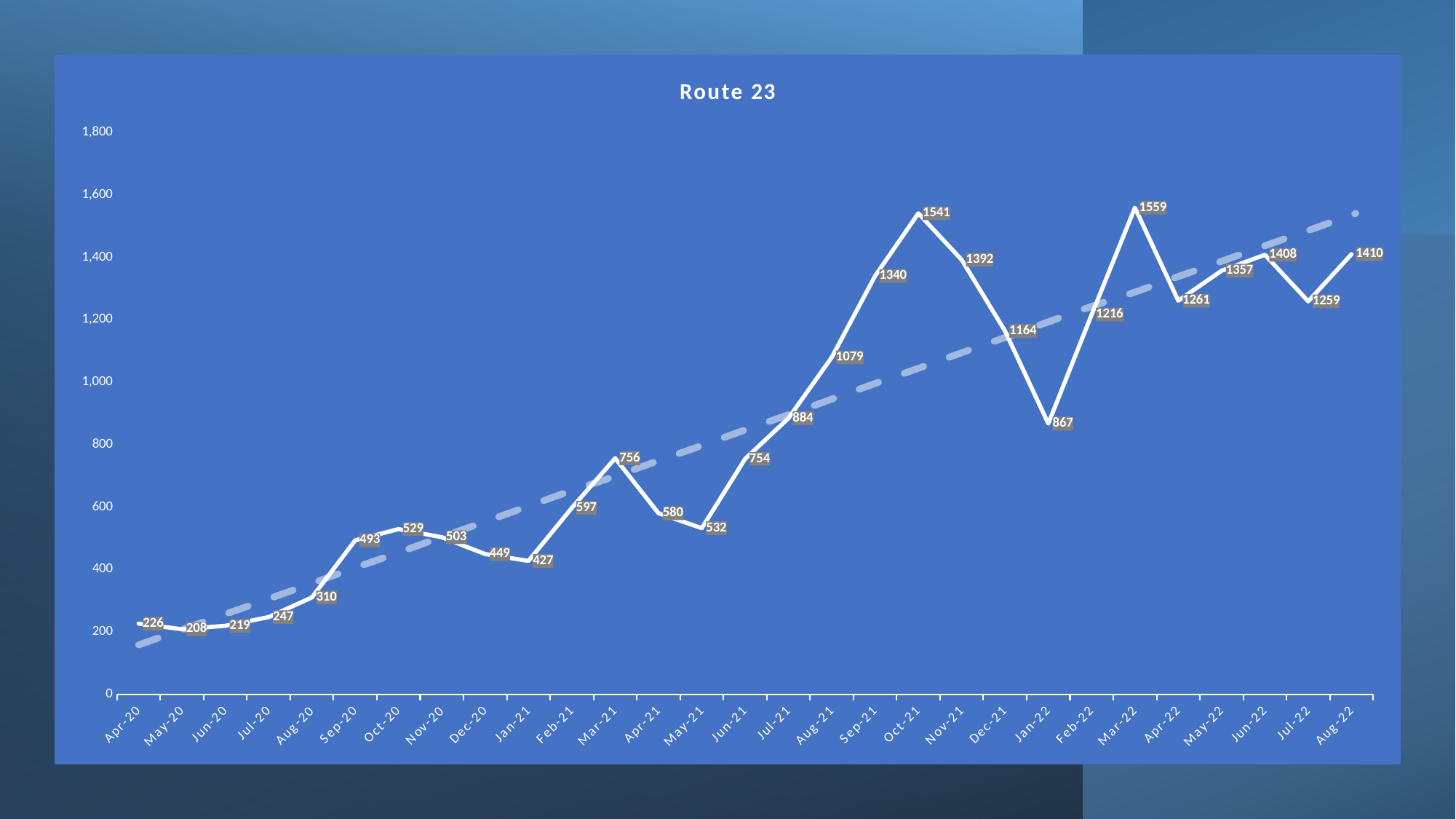
What type of chart is shown on the slide? line chart Is the value for Dec-21 greater or less than 1,000? greater What is the value for Jan-22? 867 Which is larger, the value for Jun-22 or the value for Aug-22? Aug-22 What is the title of the chart? Route 23 What is the value for Sep-20? 493 Overall, do the values rise or fall from Apr-20 to Aug-22? rise Which month has the highest value? Mar-22 What is the value for Oct-21? 1541 What is the difference between the values for Mar-22 and Apr-22? 298 Which month has the lowest value? May-20 How many months are plotted on the x axis? 29